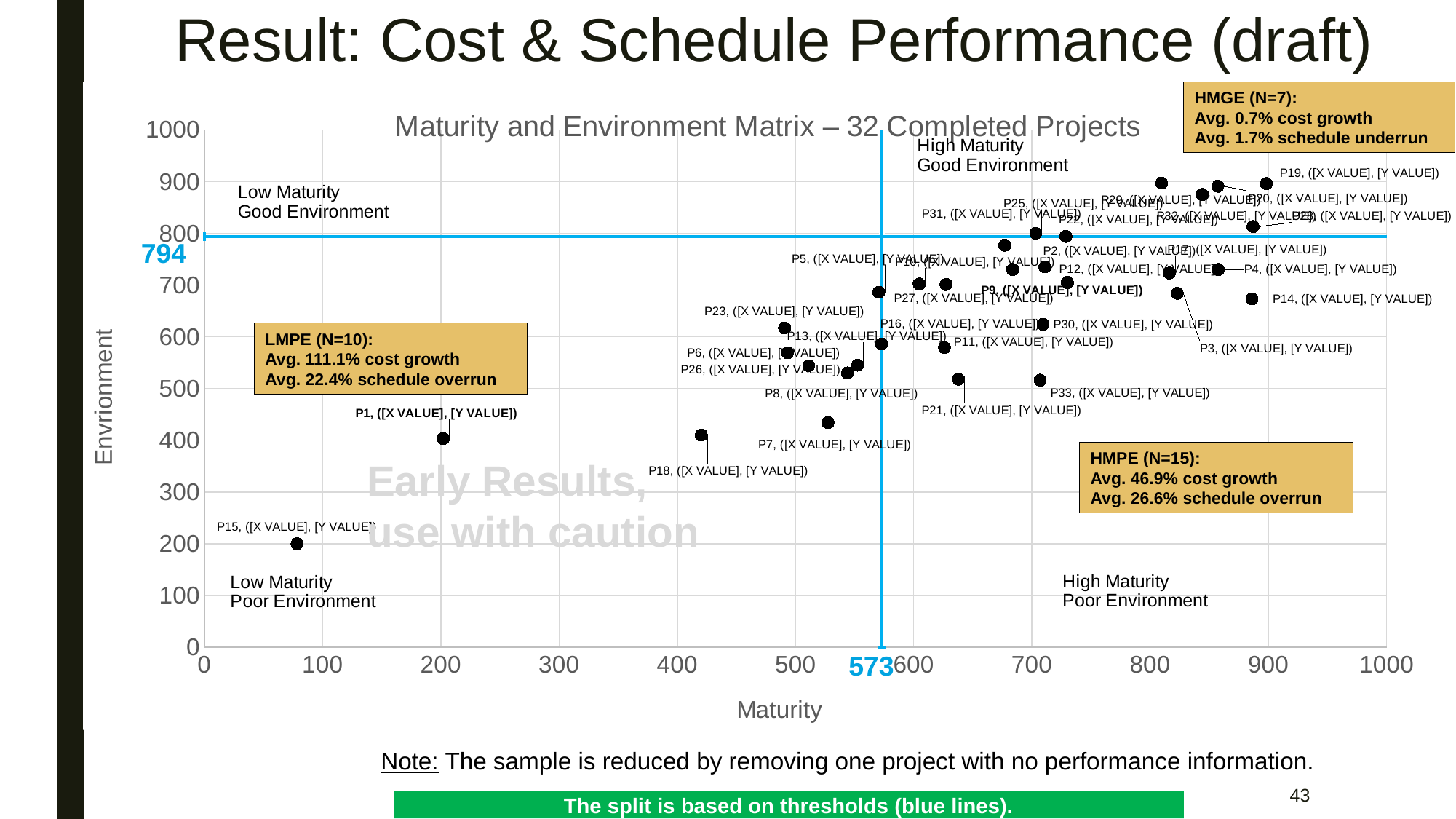
What is the label of the horizontal axis of the chart? Maturity Which project has the higher Environment value, P1 or P15? P1 Is the Environment value for P1 greater or less than 300? greater What is the title of the chart? Maturity and Environment Matrix – 32 Completed Projects Is the Maturity value for P18 greater or less than 500? less How many completed projects does the chart title say are plotted? 32 Is the Maturity value for P14 greater or less than 800? greater Which project has the higher Maturity value, P18 or P14? P14 What kind of chart is shown on the slide? scatter chart Which project has the lowest Environment value on the chart? P15 Which project has the lowest Maturity value on the chart? P15